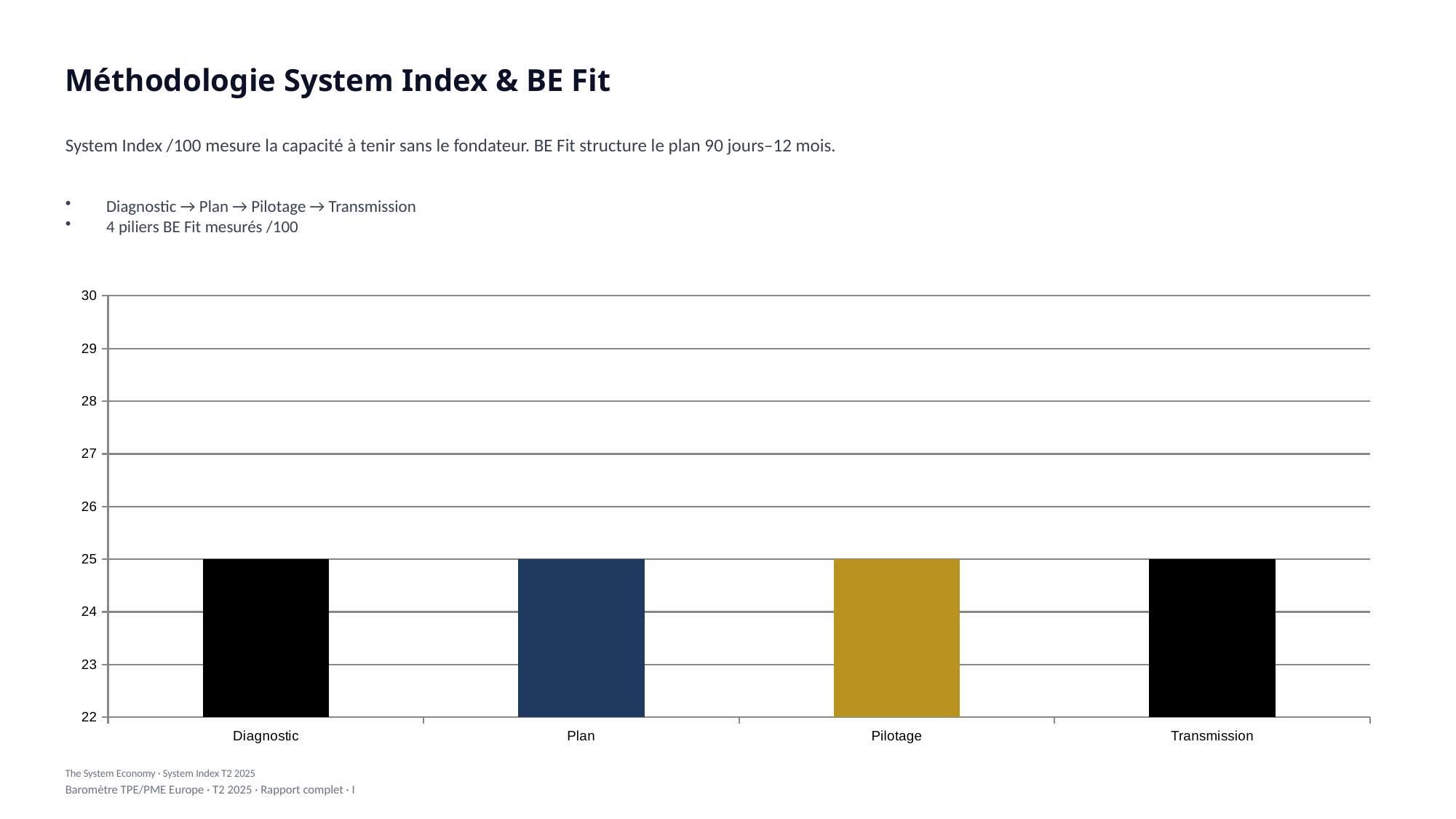
What is the value for Transmission? 25 What is the value for Diagnostic? 25 How many categories are shown on the x axis of the chart? 4 Do the values rise, fall, or stay flat from Diagnostic to Transmission? stay flat What is the difference between the values for Diagnostic and Plan? 0 Is the value for Transmission greater or less than 26? less What kind of chart is shown on the slide? bar chart What is the value for Plan? 25 What is the value for Pilotage? 25 Is the value for Pilotage greater or less than 24? greater What colour is the bar for Pilotage? gold What colour is the bar for Plan? dark blue